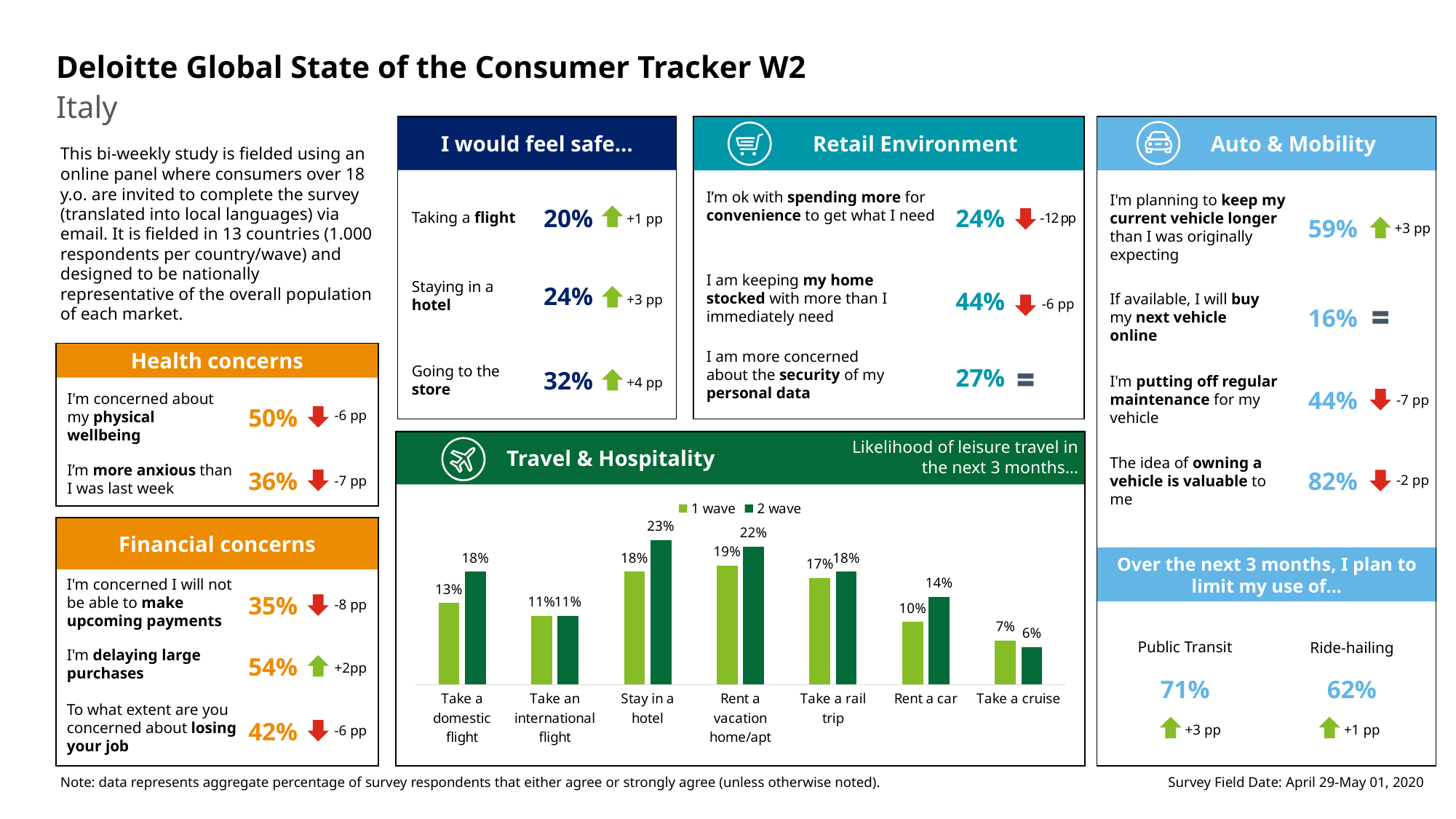
In the Travel & Hospitality chart, what is the difference between the 2 wave values for 'Rent a vacation home/apt' and 'Take a rail trip'? 4 pp In the Travel & Hospitality chart, what is the 2 wave value for 'Stay in a hotel'? 23% In the Travel & Hospitality chart, what is the 2 wave value for 'Rent a car'? 14% In the Travel & Hospitality chart, what is the 1 wave value for 'Take a domestic flight'? 13% What kind of chart is used in the Travel & Hospitality section? Bar chart In the Travel & Hospitality chart, what is the difference between the 2 wave and 1 wave values for 'Take a domestic flight'? 5 pp What are the two legend entries in the Travel & Hospitality chart? 1 wave and 2 wave In the Travel & Hospitality chart, which category has the lowest 1 wave value? Take a cruise In the Travel & Hospitality chart, which is larger for 'Take a cruise': the 1 wave value or the 2 wave value? 1 wave In the Travel & Hospitality chart, which category has the highest 2 wave value? Stay in a hotel In the Travel & Hospitality chart, how many travel categories are shown on the x axis? 7 How many series does the legend of the Travel & Hospitality chart list? 2